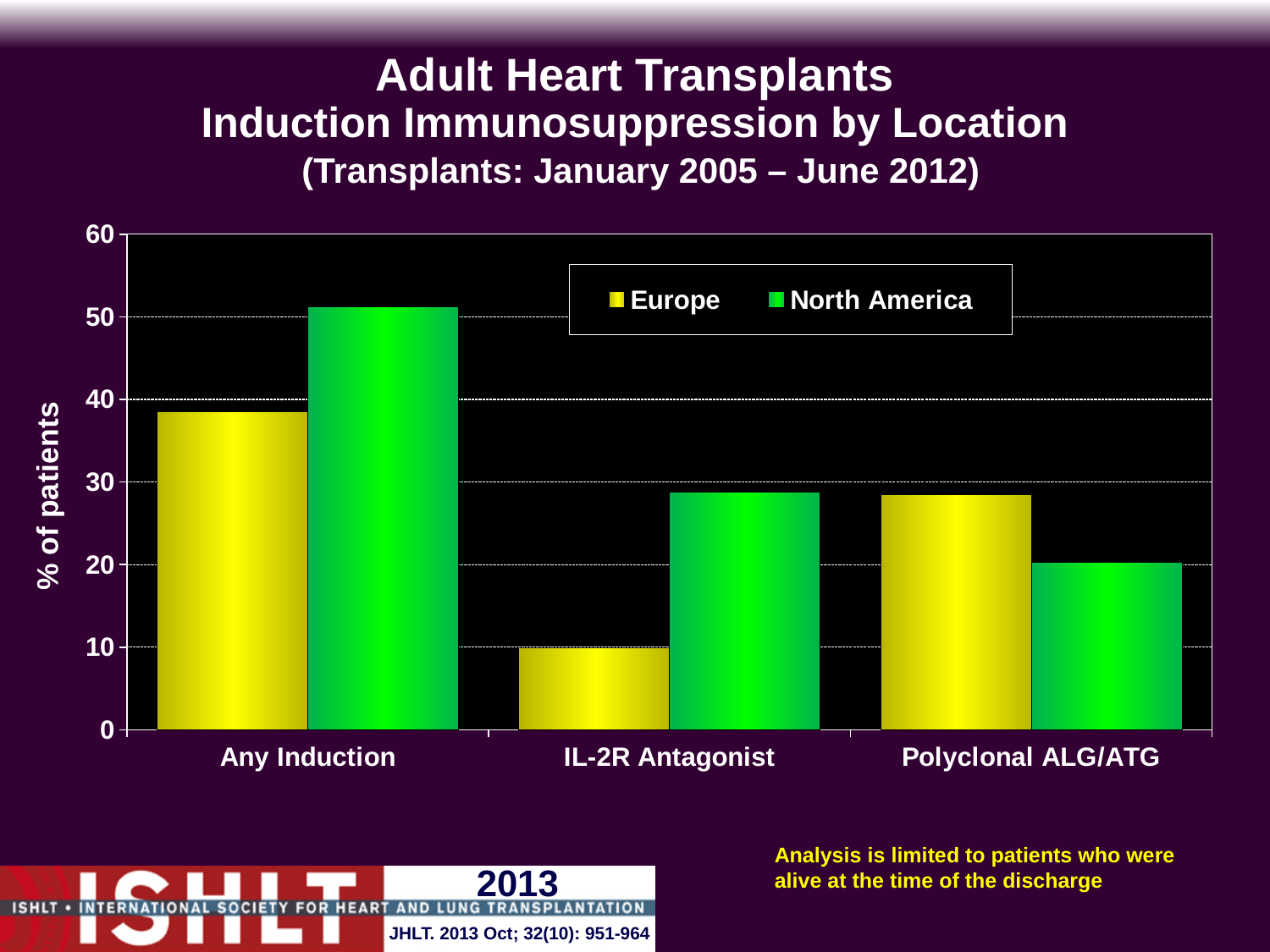
What kind of chart is shown on the slide? bar chart For Polyclonal ALG/ATG, which region has the higher percentage of patients, Europe or North America? Europe Is the value for North America under Polyclonal ALG/ATG greater or less than 30? less For IL-2R Antagonist, which region has the higher percentage of patients, Europe or North America? North America What is the label on the y axis of the chart? % of patients Is the value for Europe under IL-2R Antagonist greater or less than 20? less For Any Induction, which region has the higher percentage of patients, Europe or North America? North America Which category has the tallest bar in the chart? Any Induction (North America) How many induction categories are shown on the x axis? 3 Is the value for North America under Any Induction greater or less than 40? greater Which bar is the lowest in the chart? IL-2R Antagonist (Europe) How many series does the legend list? 2